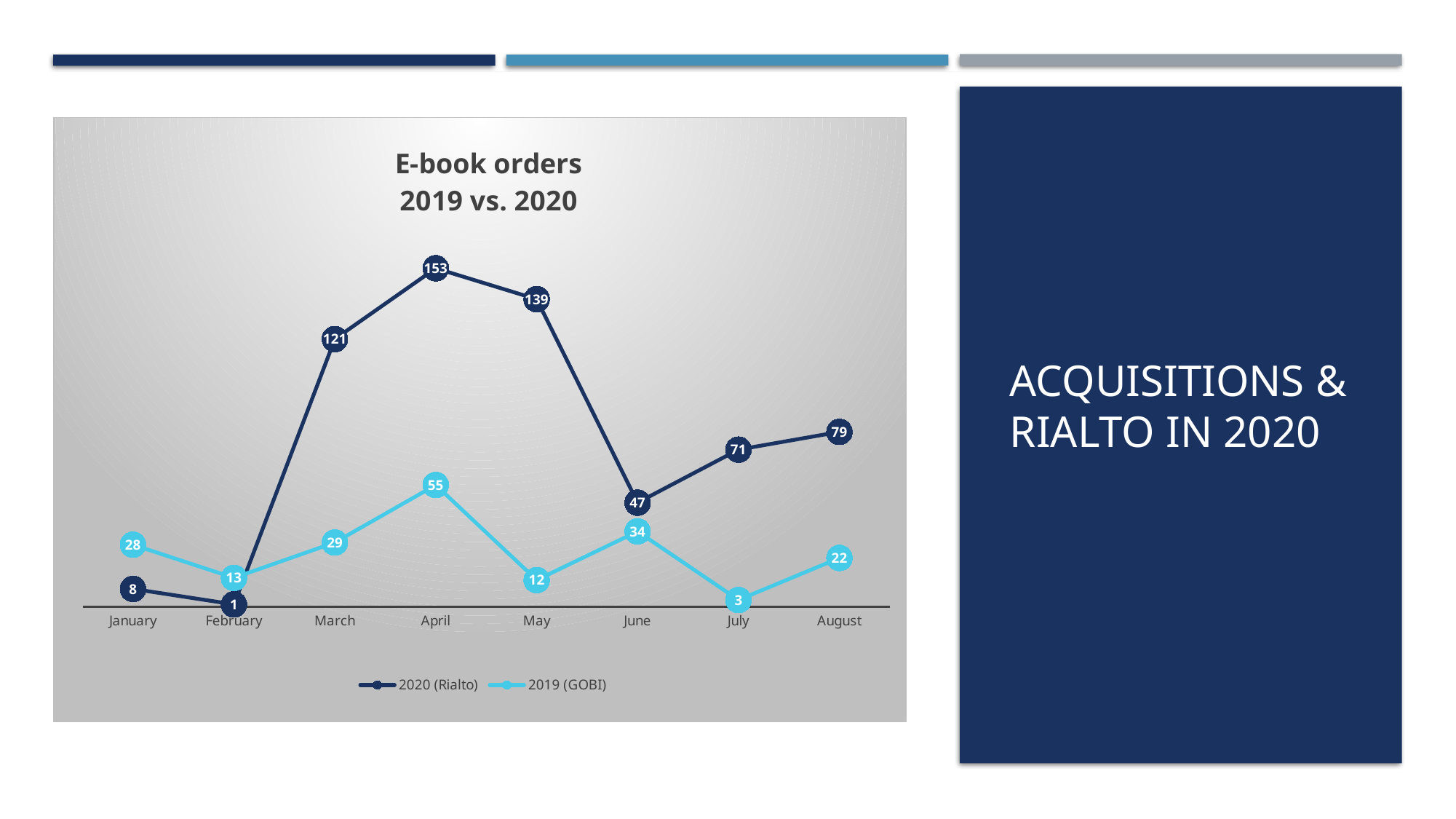
What is the title of the chart? E-book orders 2019 vs. 2020 How many series does the legend list? 2 What is the difference between 2020 (Rialto) and 2019 (GOBI) in March? 92 Does the 2020 (Rialto) series rise or fall from April to June? Fall In which month is the 2019 (GOBI) series lowest? July In which month is the 2020 (Rialto) series highest? April How many months are shown on the x axis? 8 What is the value for 2019 (GOBI) in June? 34 What kind of chart is shown? Line chart What is the value for 2020 (Rialto) in February? 1 Which series has the larger value in January, 2020 (Rialto) or 2019 (GOBI)? 2019 (GOBI) What is the value for 2020 (Rialto) in April? 153